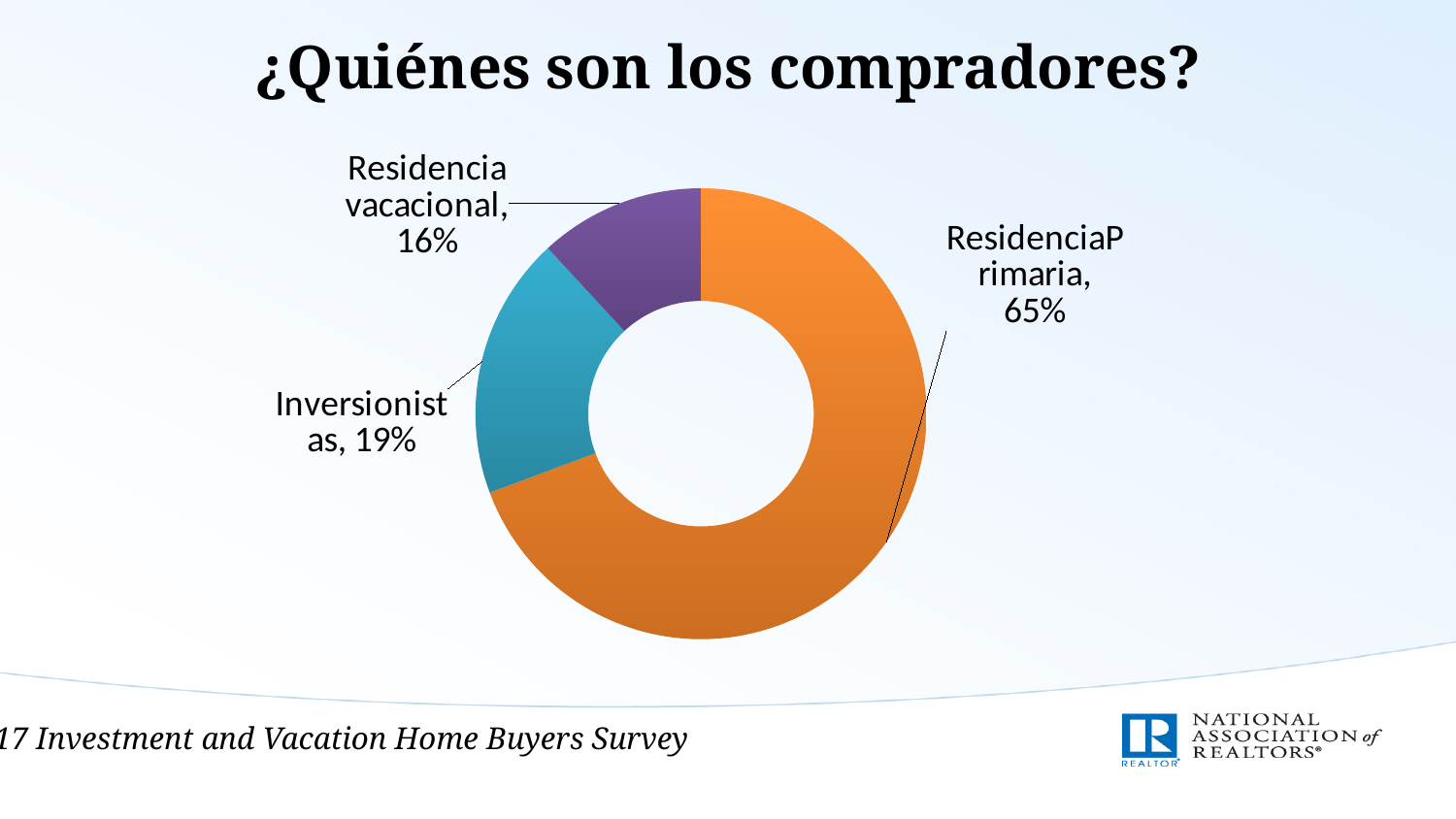
What share of buyers is Residencia vacacional? 16% What is the title of the slide? ¿Quiénes son los compradores? How many categories are shown in the chart? 3 Which category has the largest share of the chart? Residencia Primaria What colour is the Residencia Primaria slice? Orange What kind of chart is shown on the slide? Pie chart (doughnut) What is the difference between the Inversionistas share and the Residencia vacacional share? 3% Which is larger, the share for Inversionistas or the share for Residencia vacacional? Inversionistas What is the difference between the Residencia Primaria share and the Inversionistas share? 46% What share of buyers is Residencia Primaria? 65% Which category has the smallest share of the chart? Residencia vacacional What share of buyers is Inversionistas? 19%